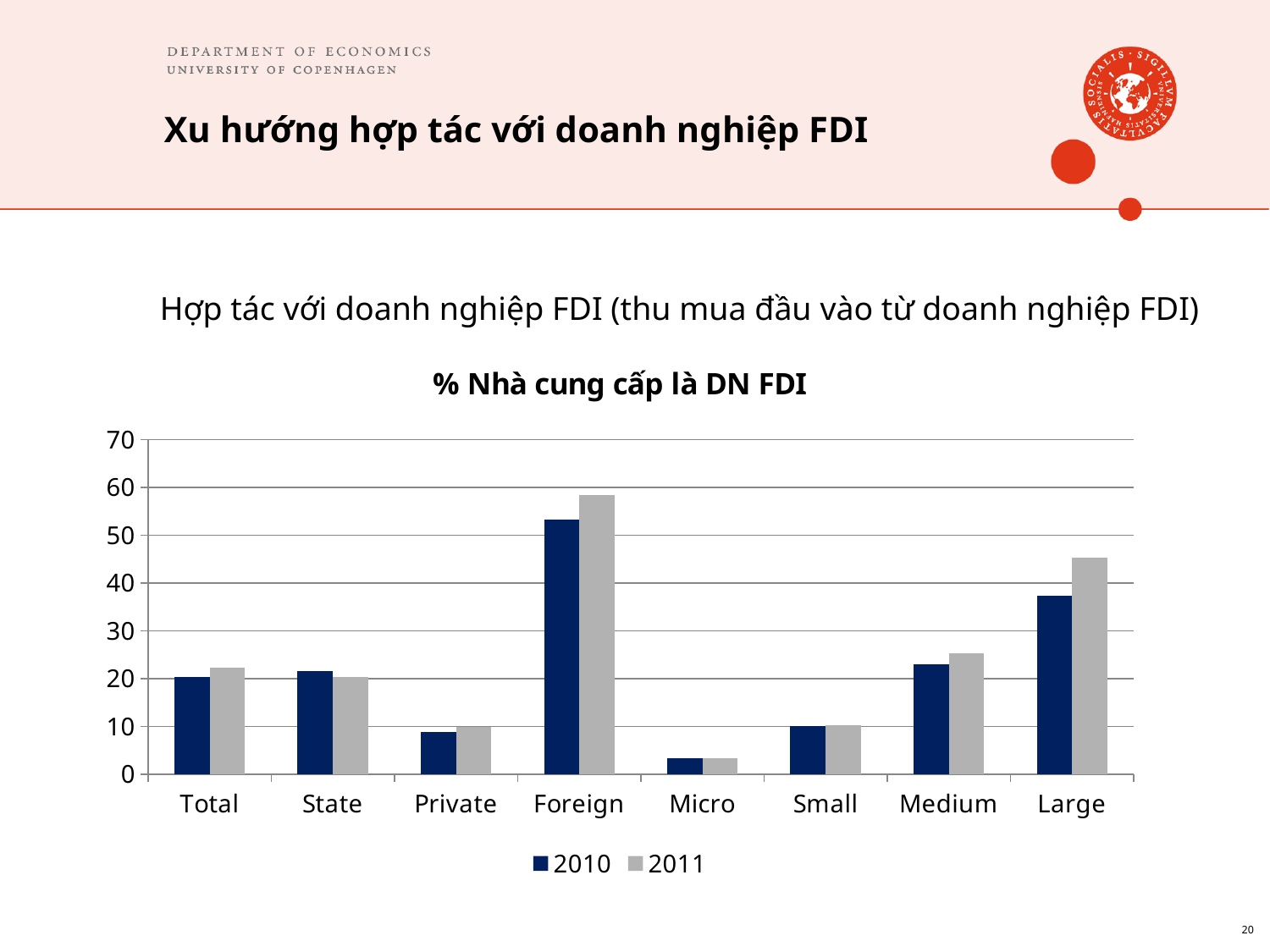
Is the value for Medium in 2011 greater or less than 20? greater For Large, which year has the larger value, 2010 or 2011? 2011 What kind of chart is shown on the slide? Bar chart In 2011, which is larger, the value for Foreign or the value for Large? Foreign How many categories are shown on the x axis? 8 Is the value for Large in 2011 greater or less than 40? greater How many series does the legend list? 2 Which category has the highest value for 2011? Foreign Is the value for Foreign in 2010 greater or less than 50? greater What is the title of the chart? % Nhà cung cấp là DN FDI Which category has the lowest value for 2010? Micro